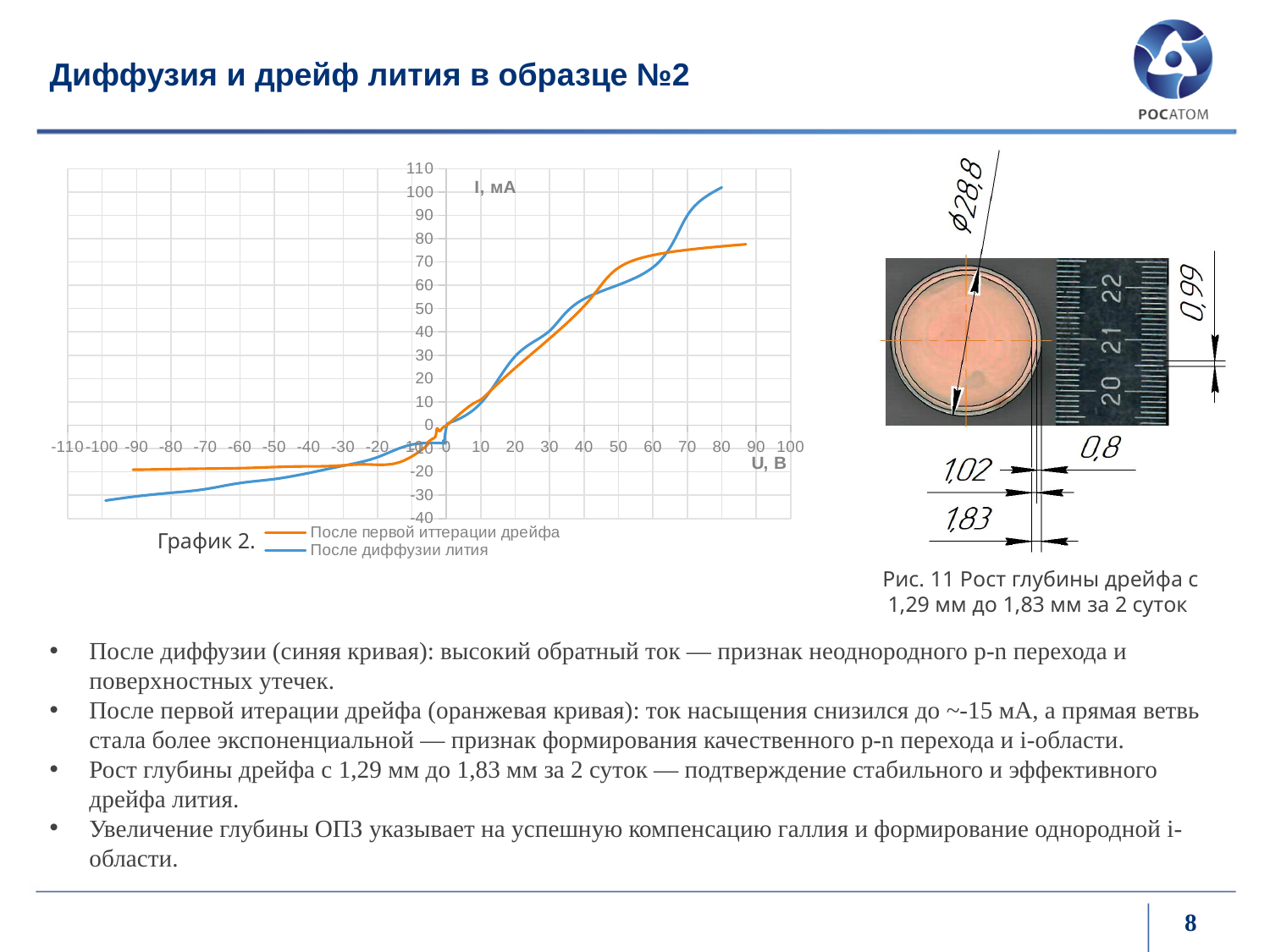
Which series in the chart is drawn in orange? После первой иттерации дрейфа What is the label of the vertical axis of the chart? I, мА Is the value of the series 'После первой иттерации дрейфа' at U = 90 В greater or less than 70? greater Is the value of the series 'После первой иттерации дрейфа' at U = -90 В greater or less than -20? greater Do the currents of both series rise or fall as U increases along the x axis? rise What kind of chart is shown on the slide (График 2)? line chart Which series reaches the highest current value on the chart? После диффузии лития At U = 80 В, which series has the higher current: 'После диффузии лития' or 'После первой иттерации дрейфа'? После диффузии лития How many series does the legend of the chart list? 2 Is the value of the series 'После диффузии лития' at U = 80 В greater or less than 90? greater